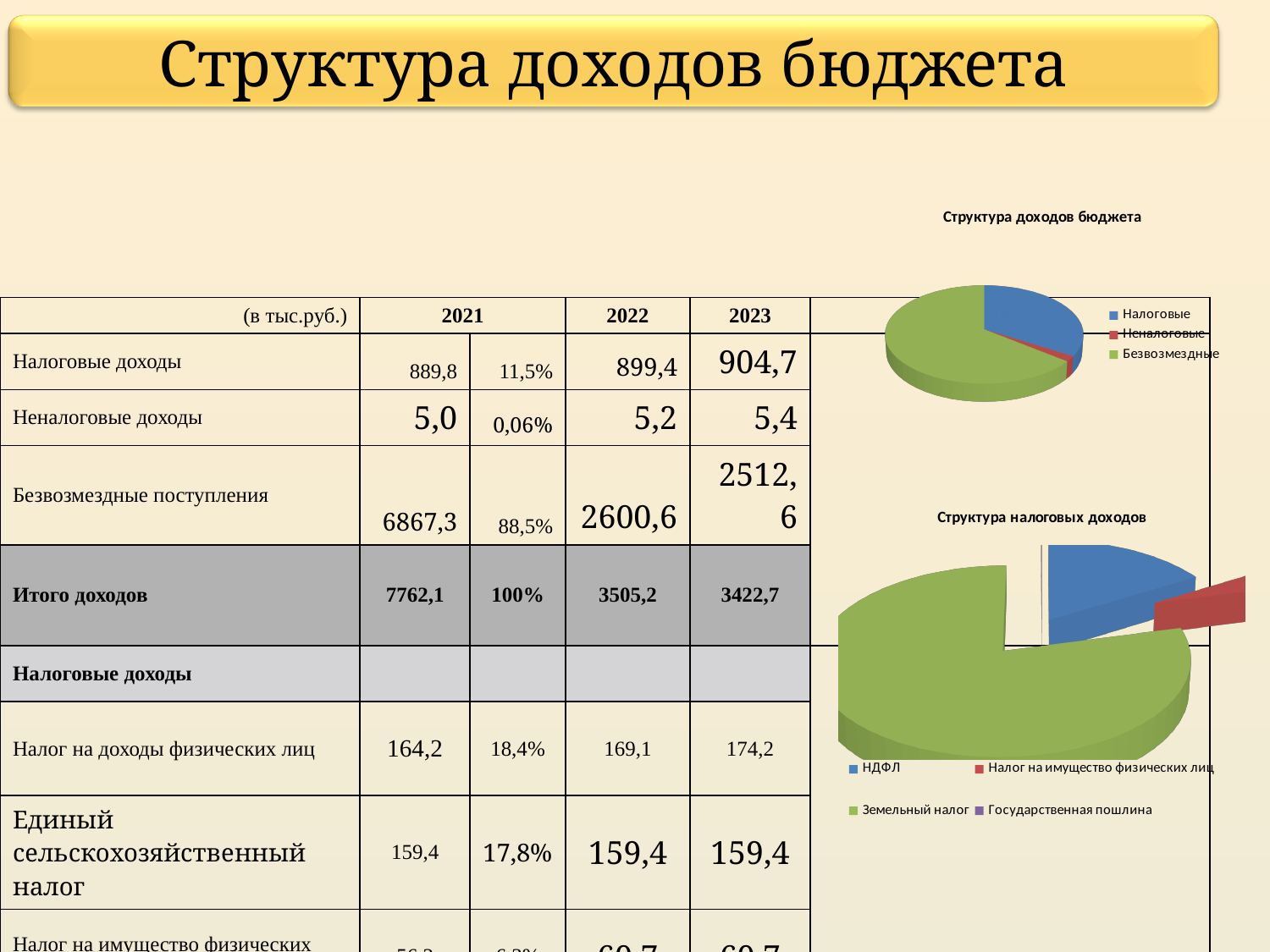
In the chart titled "Структура доходов бюджета", what colour is the Безвозмездные slice? green What kind of chart is the chart titled "Структура налоговых доходов"? pie chart In the chart titled "Структура налоговых доходов", which category has the largest slice? Земельный налог In the chart titled "Структура налоговых доходов", how many categories does the legend list? 4 In the chart titled "Структура доходов бюджета", which slice is larger: Налоговые or Неналоговые? Налоговые In the chart titled "Структура доходов бюджета", which category has the smallest slice? Неналоговые In the chart titled "Структура налоговых доходов", which category has the smallest slice? Государственная пошлина In the chart titled "Структура доходов бюджета", how many categories does the legend list? 3 What kind of chart is the chart titled "Структура доходов бюджета"? pie chart In the chart titled "Структура доходов бюджета", which category has the largest slice? Безвозмездные In the chart titled "Структура налоговых доходов", which slice is larger: НДФЛ or Налог на имущество физических лиц? НДФЛ In the chart titled "Структура налоговых доходов", what colour is the НДФЛ slice? blue